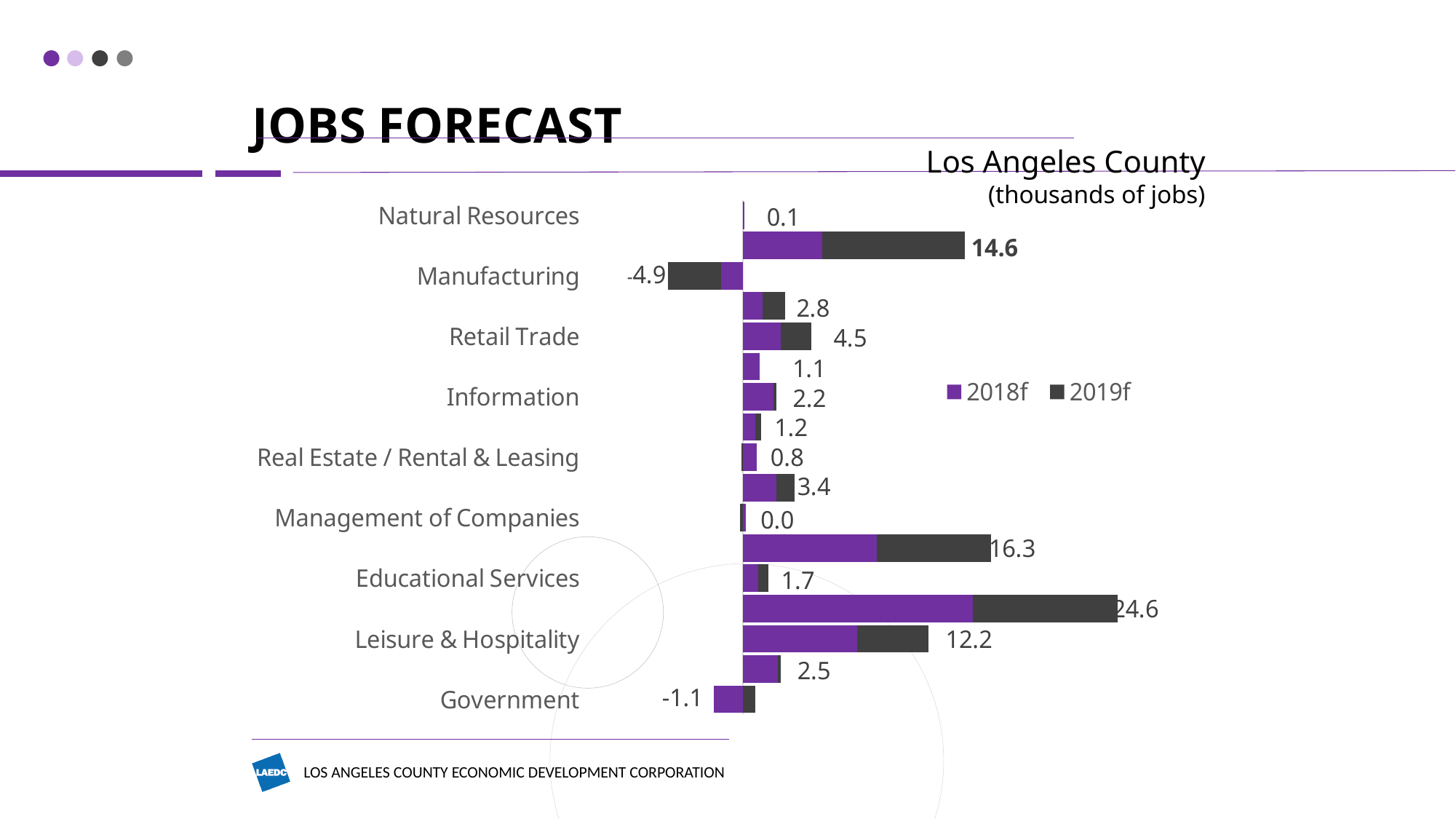
What are the two series named in the legend? 2018f and 2019f What is the total value shown for Manufacturing? -4.9 What kind of chart is shown on the slide? Stacked bar chart Among the labelled categories, which has the lowest total value? Manufacturing What is the total value shown for Leisure & Hospitality? 12.2 Which has a larger total value, Educational Services or Information? Information How many series does the legend list? 2 What is the total value shown for Management of Companies? 0.0 What is the total value shown for Government? -1.1 Among the labelled categories, which has the highest total value? Leisure & Hospitality What is the difference between the total values for Retail Trade and Information? 2.3 What is the total value shown for Retail Trade? 4.5